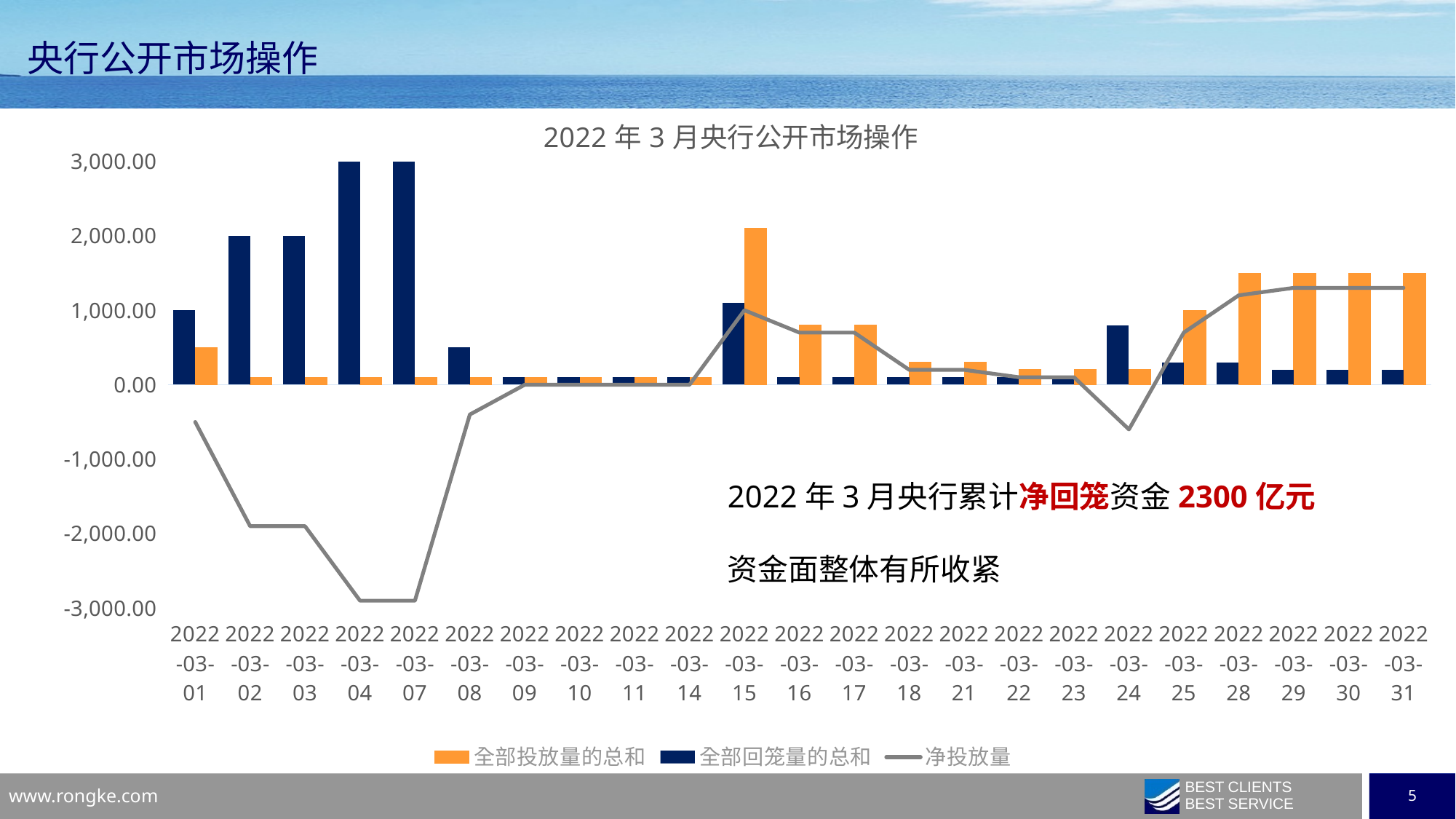
Is the value of 全部投放量的总和 on 2022-03-15 greater or less than 2,000.00? greater How many dates are shown on the x axis? 23 On 2022-03-02, which is larger: 全部投放量的总和 or 全部回笼量的总和? 全部回笼量的总和 Does 净投放量 rise or fall from 2022-03-01 to 2022-03-07? fall What is the value of 全部回笼量的总和 on 2022-03-01? 1,000.00 Is the value of 净投放量 on 2022-03-24 greater or less than 0.00? less On which date is 全部投放量的总和 the highest? 2022-03-15 What is the title of the chart? 2022年3月央行公开市场操作 How many series does the legend list? 3 What kind of chart is shown on the slide? A combination bar and line chart What is the value of 全部回笼量的总和 on 2022-03-02? 2,000.00 What is the value of 全部回笼量的总和 on 2022-03-04? 3,000.00